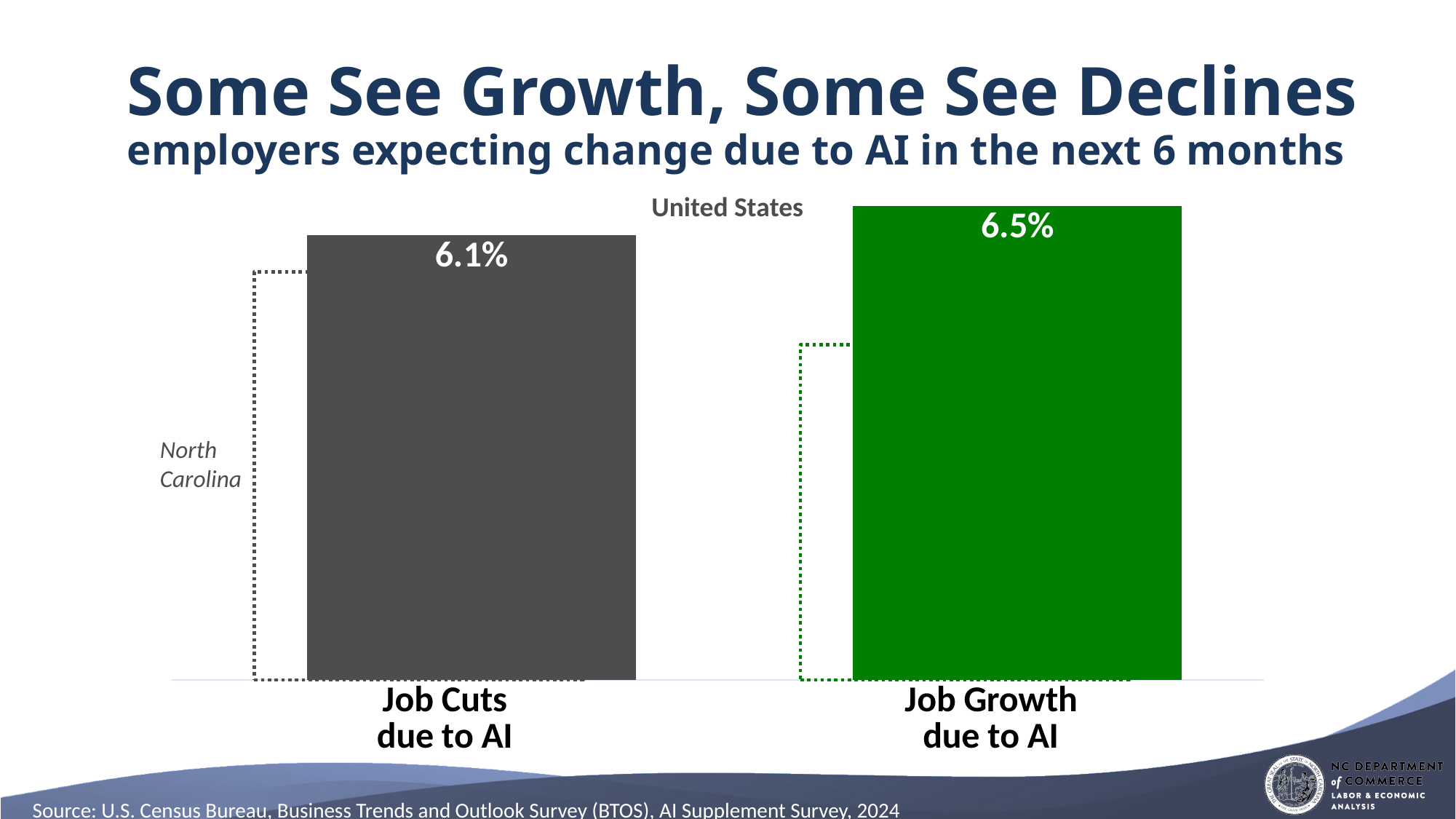
What colour is the bar for Job Growth due to AI? green Is the United States value for Job Cuts due to AI larger or smaller than the value for Job Growth due to AI? smaller For North Carolina, is the dotted outline for Job Cuts due to AI taller or shorter than the dotted outline for Job Growth due to AI? taller Which two geographies does the chart compare? United States and North Carolina How many categories are shown on the x axis of the chart? 2 What kind of chart is shown on the slide? bar chart What is the difference between the United States values for Job Growth due to AI and Job Cuts due to AI? 0.4% What percentage of United States employers expect job cuts due to AI in the next 6 months? 6.1% What percentage of United States employers expect job growth due to AI in the next 6 months? 6.5% Which category has the higher United States value, Job Cuts due to AI or Job Growth due to AI? Job Growth due to AI Which category has the lower United States value? Job Cuts due to AI